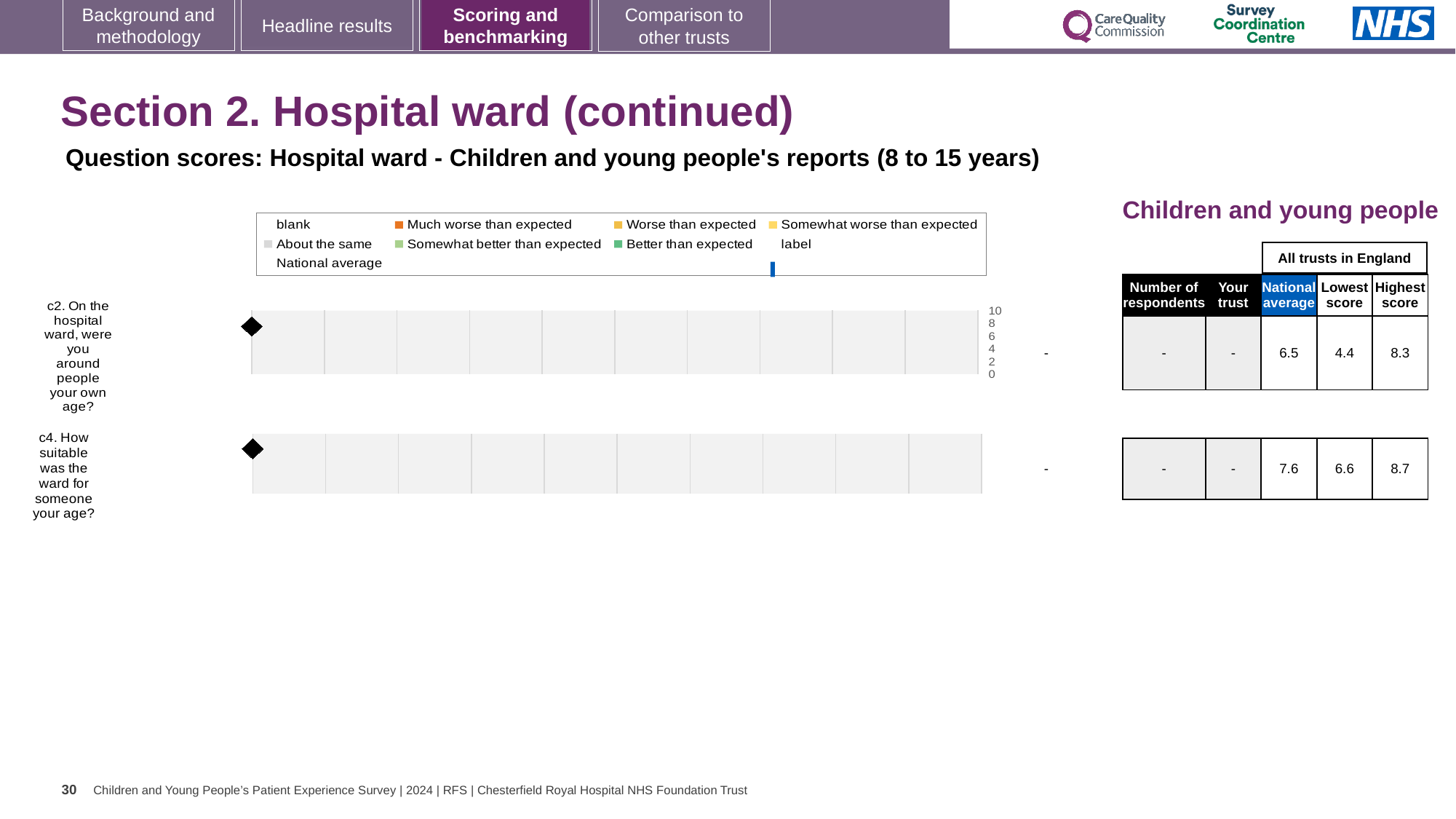
Which question has the higher national average, c2 or c4? c4 How many questions (categories) are plotted on the chart? 2 What is the difference between the highest score and the lowest score for question c2? 3.9 In the table, what is the national average score for question c2 (On the hospital ward, were you around people your own age?)? 6.5 In the chart legend, what colour represents 'Much worse than expected'? orange What value is shown for 'Your trust' for question c2? - Is the national average for question c4 greater or less than 6? greater In the table, what is the national average score for question c4 (How suitable was the ward for someone your age?)? 7.6 In the table, what is the lowest score across all trusts in England for question c2? 4.4 What is the highest value shown on the chart's axis? 10 In the table, what is the highest score across all trusts in England for question c4? 8.7 What kind of chart is used to display the question scores on this slide? bar chart